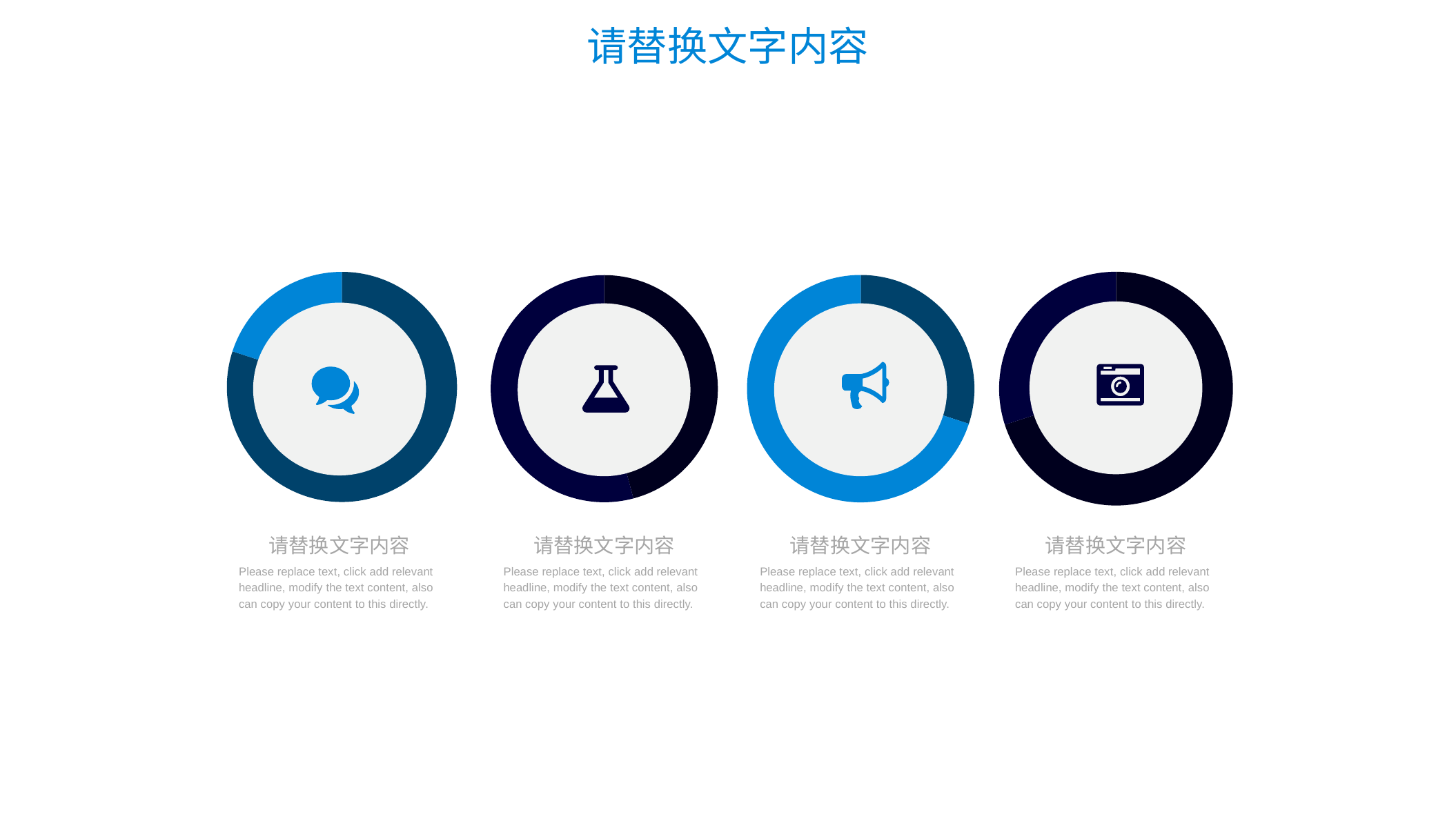
In the third donut chart from the left, is the light blue segment more or less than half of the ring? More In the third donut chart from the left, which segment is larger, the light blue one or the dark blue one? The light blue one In the leftmost donut chart, is the light blue segment more or less than half of the ring? Less What kind of chart is the leftmost chart on the slide? Donut chart In the rightmost donut chart, which segment is larger, the navy one or the black one? The black one How many segments does the rightmost donut chart have? 2 What icon is shown in the centre of the rightmost donut chart? A camera How many donut charts are shown on the slide? 4 In the leftmost donut chart, which segment is larger, the light blue one or the dark blue one? The dark blue one What icon is shown in the centre of the second donut chart from the left? A flask How many segments does the leftmost donut chart have? 2